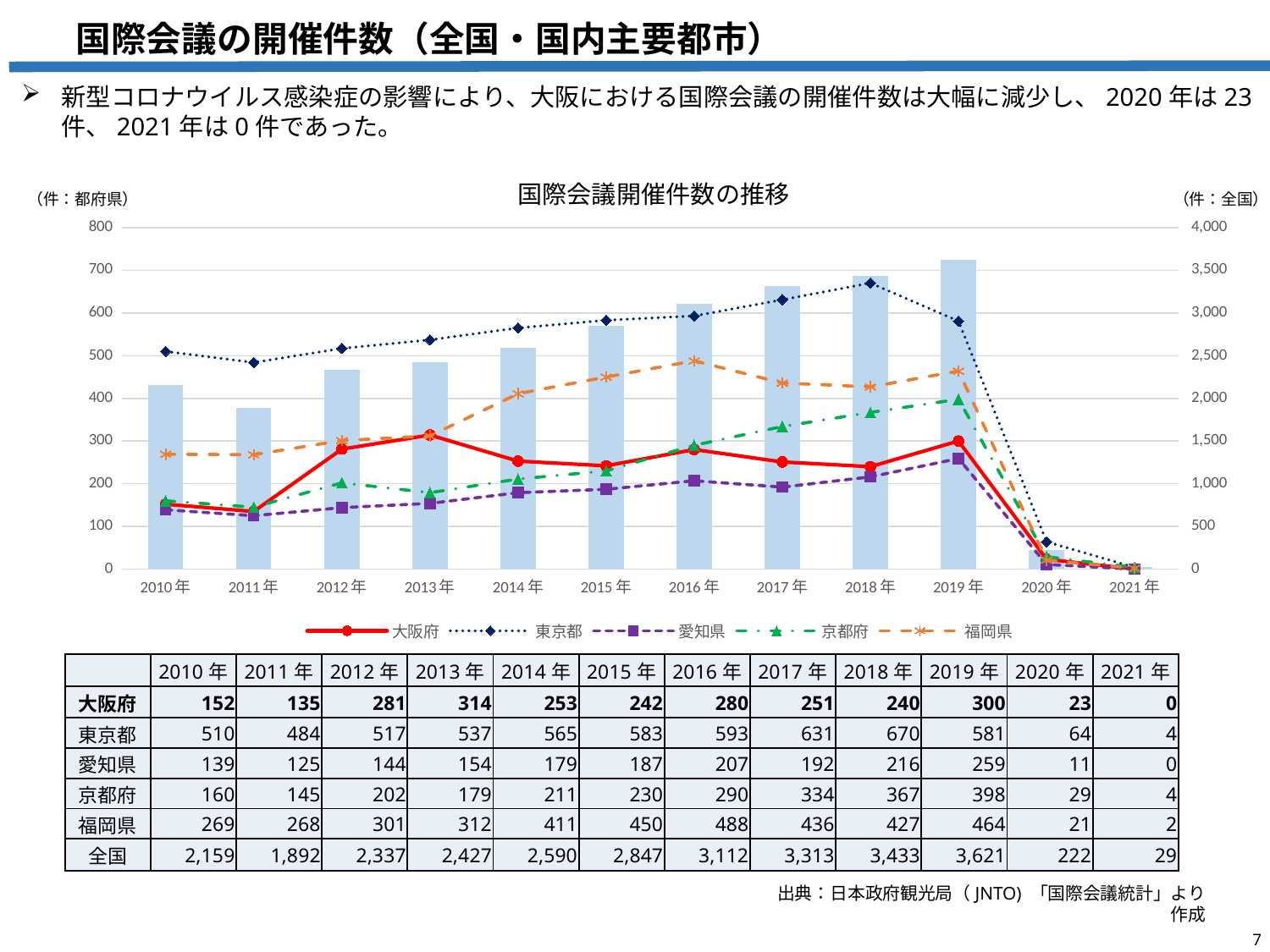
In which year does 全国 reach its highest value? 2019年 What is the value for 大阪府 in 2019年? 300 In which year does 大阪府 reach its highest value? 2013年 How many years are plotted along the x axis of the chart? 12 How many series does the chart legend list? 5 In 2015年, which is larger, the value for 京都府 or the value for 愛知県? 京都府 What is the value for 全国 in 2019年? 3,621 What kind of chart is shown on the slide? Combined bar and line chart What is the value for 東京都 in 2018年? 670 What is the difference between the 大阪府 values for 2019年 and 2020年? 277 Do the 全国 values rise or fall from 2016年 to 2019年? Rise What is the title of the chart? 国際会議開催件数の推移